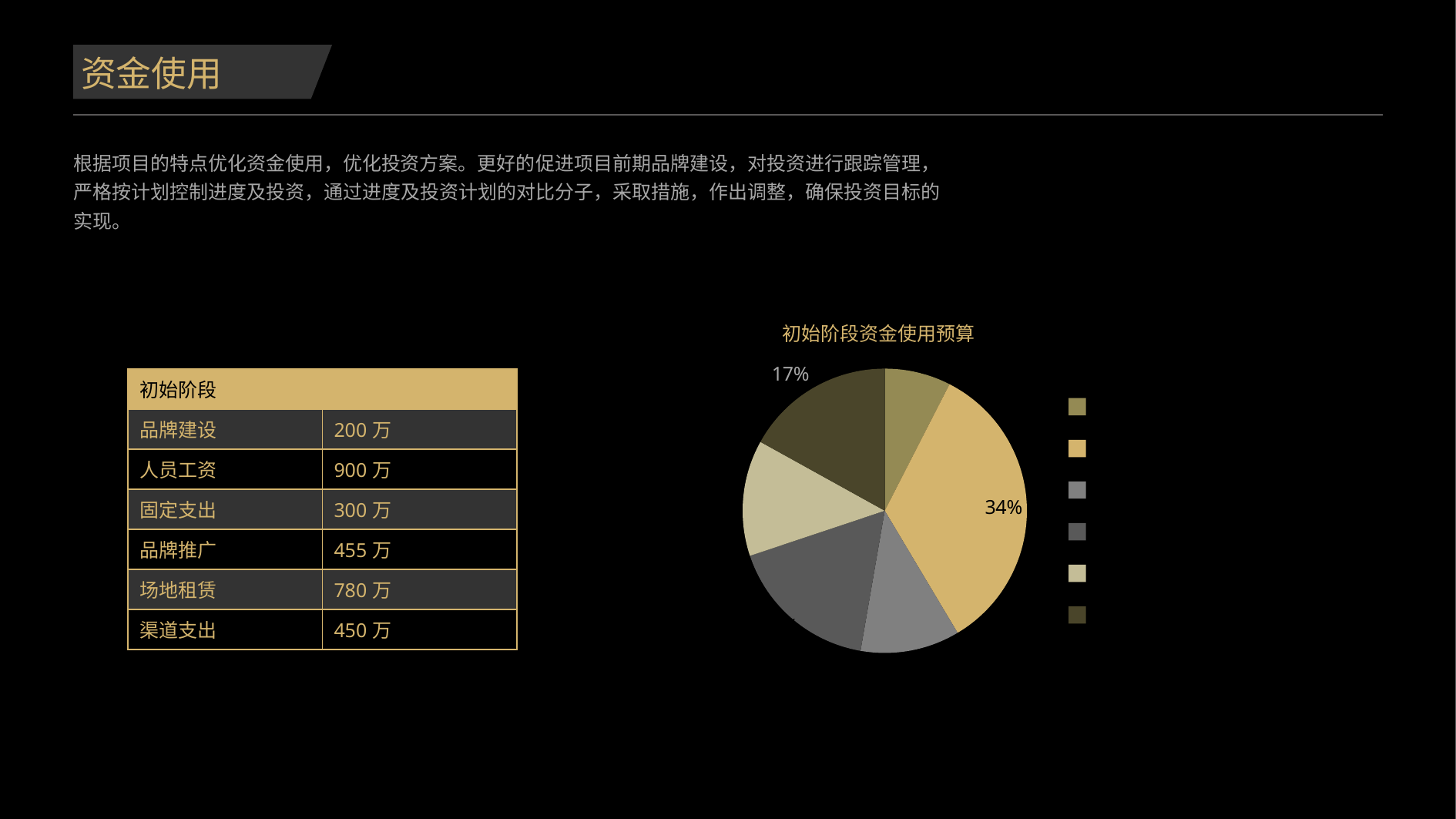
Is the share of the slice labelled 34% greater or less than 30%? greater What is the title of the pie chart? 初始阶段资金使用预算 What is the difference between the two percentages printed on the pie chart, 34% and 17%? 17% Is the share of the slice labelled 17% greater or less than 20%? less How many slices does the pie chart have? 6 What type of chart is shown on the slide? pie chart What percentage is printed on the largest slice of the pie chart? 34% What percentage is printed on the dark olive slice at the top-left of the pie chart? 17% How many entries does the legend of the pie chart show? 6 Which slice of the pie chart is the largest? the gold slice labelled 34% Which is larger in the pie chart: the slice labelled 34% or the slice labelled 17%? the slice labelled 34%